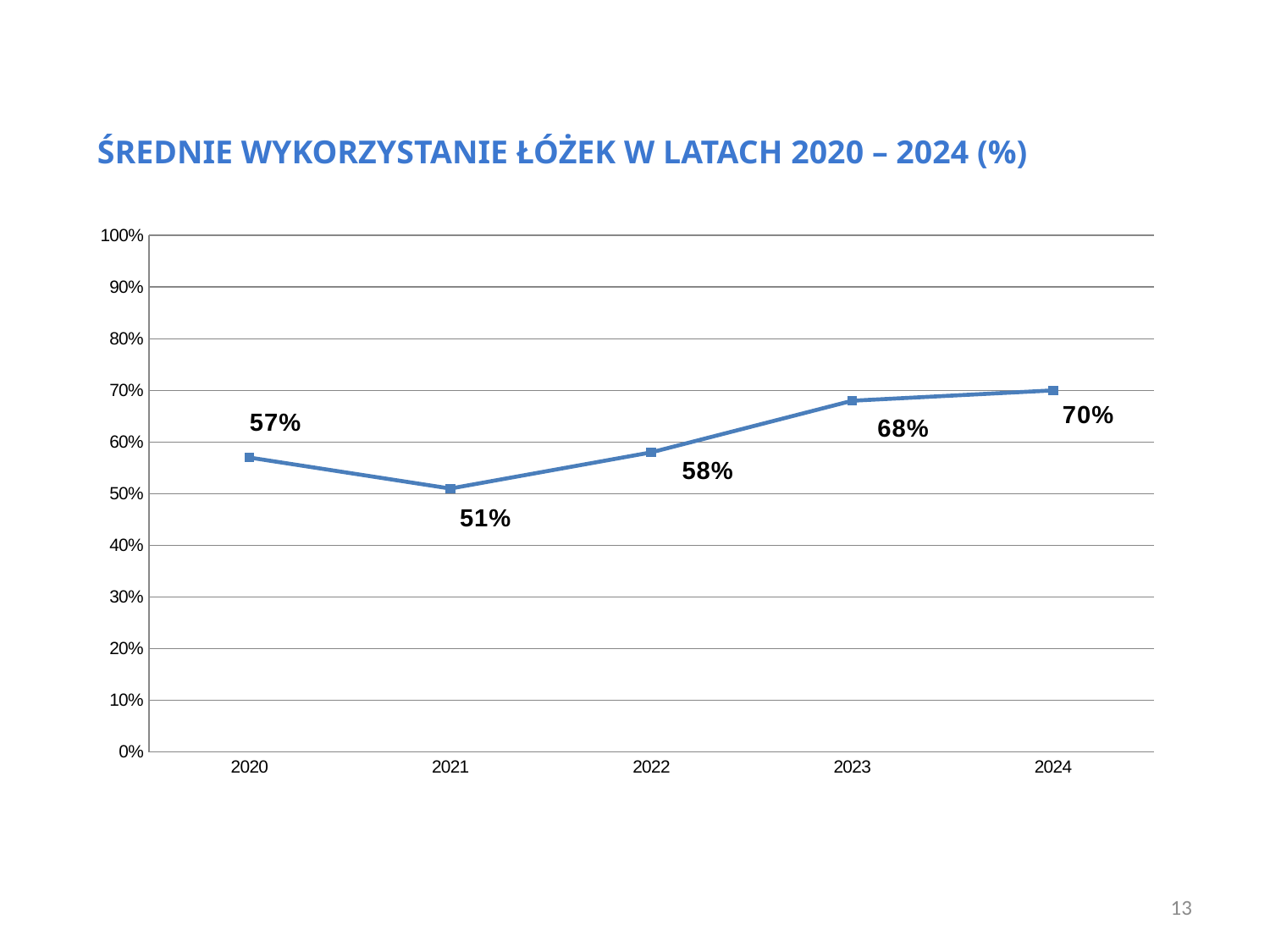
Do the values rise or fall from 2021 to 2024? rise What kind of chart is shown on the slide? line chart Which year has the lowest value on the chart? 2021 Is the value for 2023 greater or less than 60%? greater What is the average bed utilisation value for 2020? 57% What is the value shown for 2023? 68% What is the difference between the values for 2024 and 2021? 19% How many years are plotted on the chart? 5 What is the value shown for 2021? 51% Which year has the highest value on the chart? 2024 Which year has a larger value, 2020 or 2022? 2022 What is the difference between the values for 2023 and 2022? 10%